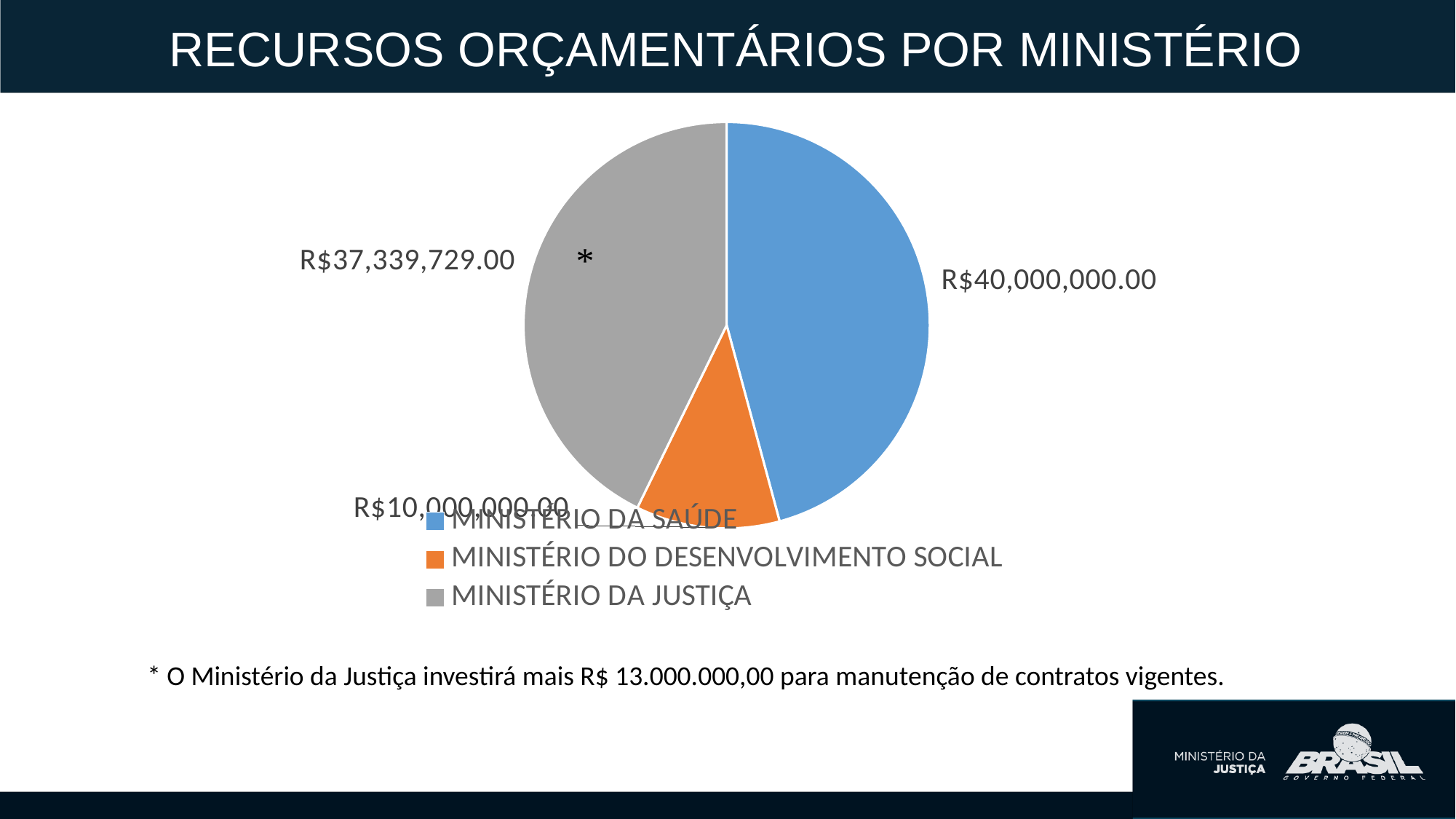
Which ministry has the largest budget share in the pie chart? Ministério da Saúde What kind of chart is shown on the slide? Pie chart What is the title of the slide containing the pie chart? RECURSOS ORÇAMENTÁRIOS POR MINISTÉRIO How many slices does the pie chart have? 3 Which is larger, the value for Ministério da Justiça or the value for Ministério do Desenvolvimento Social? Ministério da Justiça What is the value for Ministério da Justiça? R$37,339,729.00 How many entries does the legend list? 3 What is the value for Ministério da Saúde? R$40,000,000.00 Which colour represents Ministério da Justiça in the pie chart? Grey What is the difference between the values for Ministério da Saúde and Ministério da Justiça? R$2,660,271.00 What is the value for Ministério do Desenvolvimento Social? R$10,000,000.00 Which ministry has the smallest budget share in the pie chart? Ministério do Desenvolvimento Social